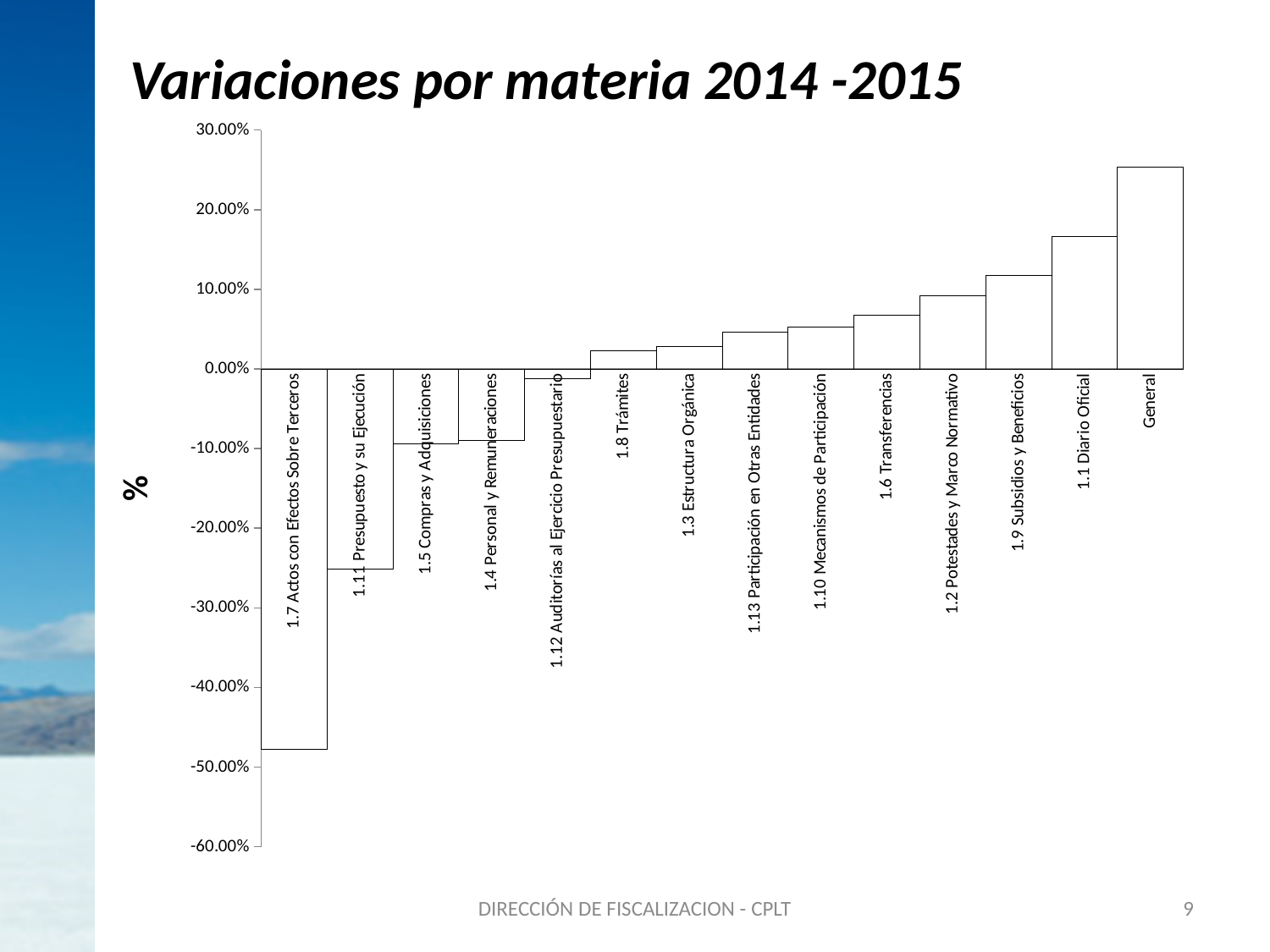
Is the value for 1.11 Presupuesto y su Ejecución greater or less than -20.00%? less How many categories are plotted on the x axis of the chart? 14 What is the title of the chart on the slide? Variaciones por materia 2014 -2015 Is the value for General greater or less than 20.00%? greater Which category has the highest value in the chart? General Which is larger, the value for General or the value for 1.1 Diario Oficial? General Is the value for 1.1 Diario Oficial greater or less than 10.00%? greater Which category has the lowest value in the chart? 1.7 Actos con Efectos Sobre Terceros What kind of chart is shown on the slide? bar chart Do the values rise or fall moving from left to right along the x axis? rise